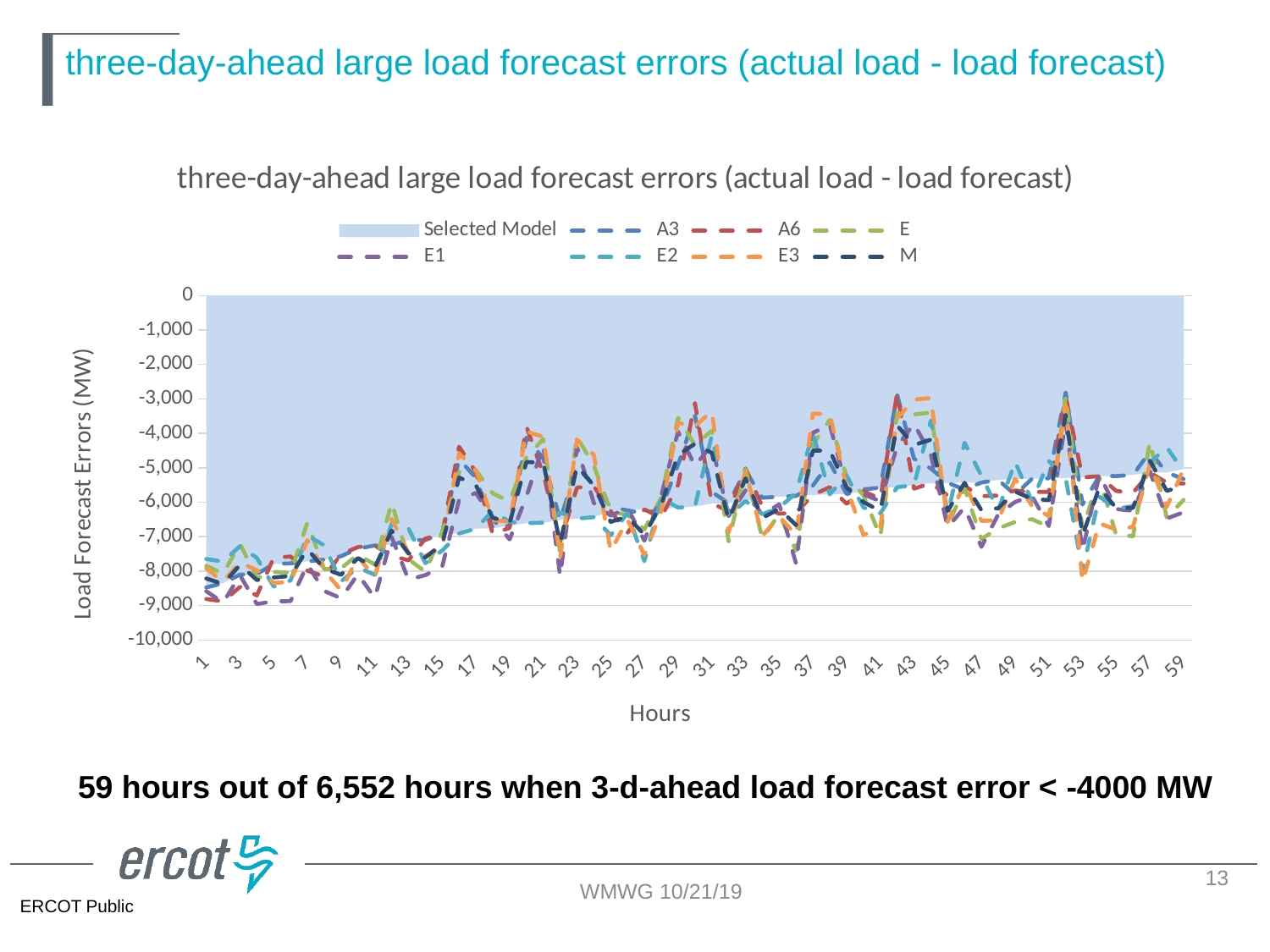
Is the value for the Selected Model at hour 1 greater or less than -7,000? less Is the value for the Selected Model at hour 59 greater or less than -6,000? greater What is the label of the x axis? Hours What is the lowest value shown on the y axis? -10,000 How many series does the chart's legend list? 8 What kind of chart is shown on the slide? combination area and line chart How many hours are plotted along the x axis? 59 Which series is drawn as a shaded area rather than a dashed line? Selected Model What is the label of the y axis? Load Forecast Errors (MW) Is the value for the Selected Model at hour 25 greater or less than -8,000? greater What is the title of the chart? three-day-ahead large load forecast errors (actual load - load forecast) Do the forecast error values generally rise or fall from hour 1 to hour 59? rise